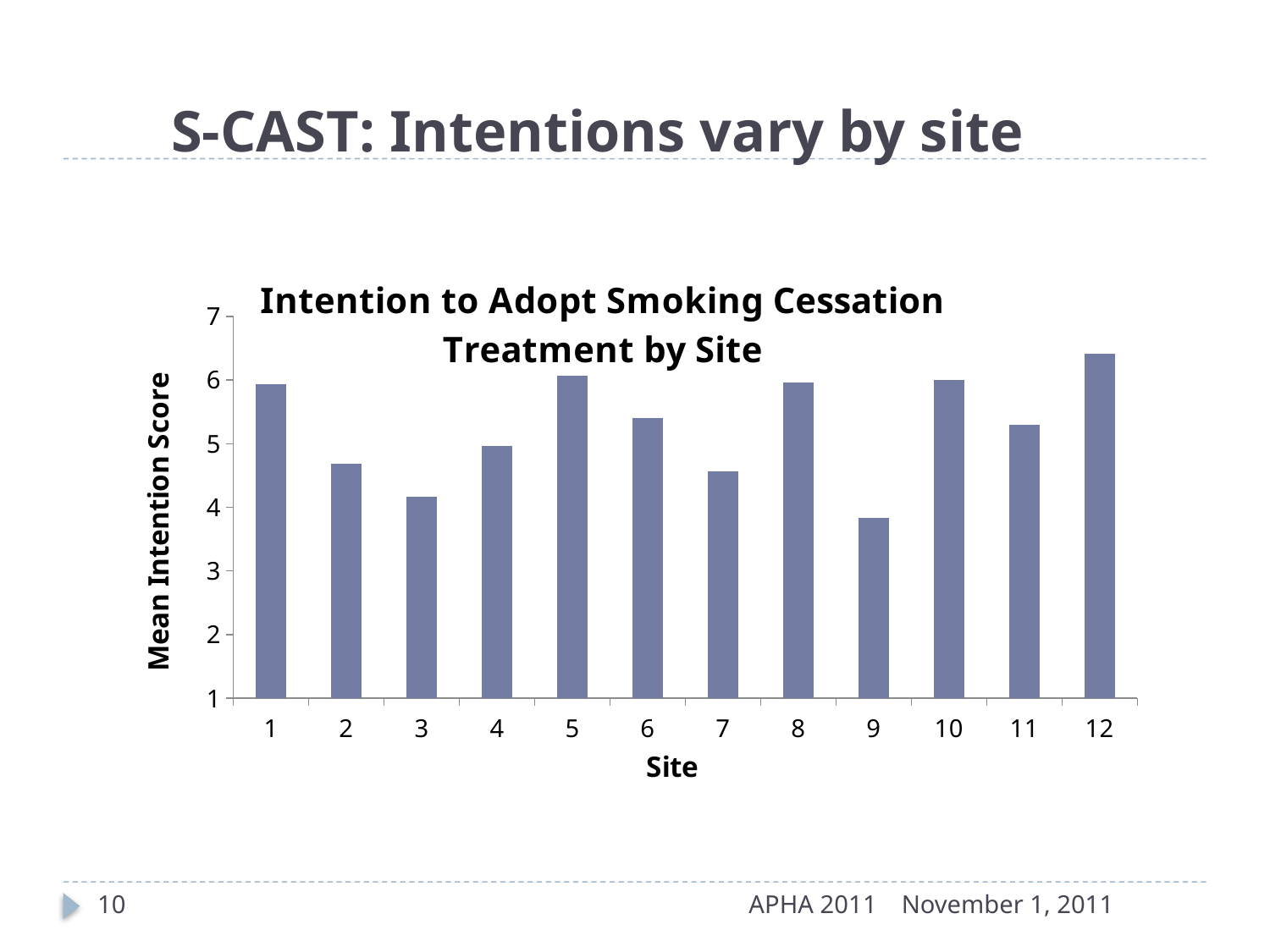
Is the mean intention score for site 6 greater or less than 5? greater How many sites are plotted on the x axis? 12 Which has a higher mean intention score, site 3 or site 2? site 2 Is the mean intention score for site 9 greater or less than 4? less What is the label on the y axis of the chart? Mean Intention Score Is the mean intention score for site 12 greater or less than 6? greater What is the title of the chart? Intention to Adopt Smoking Cessation Treatment by Site What kind of chart is shown on the slide? bar chart Which site has the highest mean intention score? 12 Which site has the lowest mean intention score? 9 Which has a higher mean intention score, site 6 or site 7? site 6